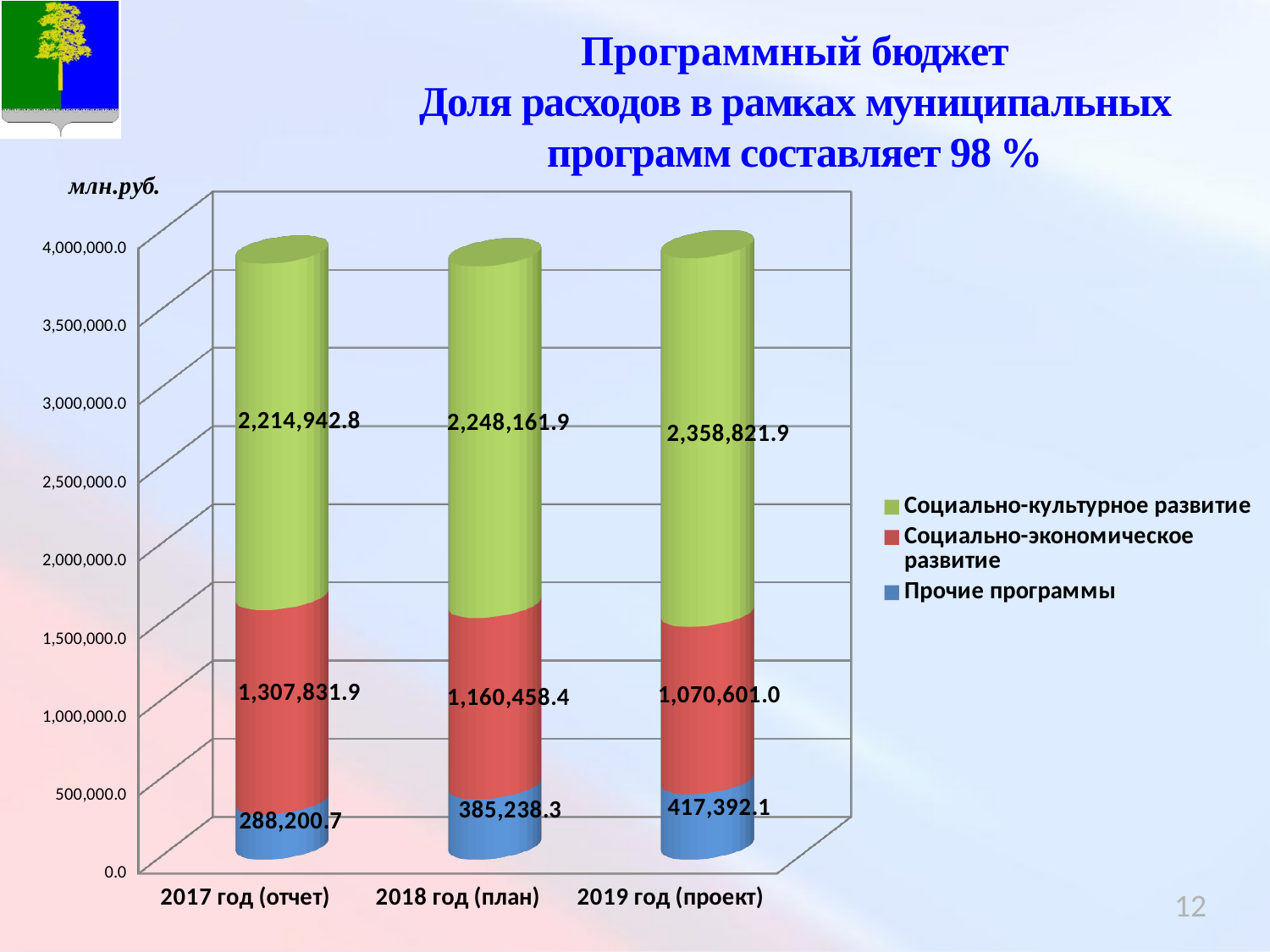
What is the difference between the Социально-экономическое развитие values for 2017 год (отчет) and 2019 год (проект)? 237,230.9 What is the total of the stacked bar for 2019 год (проект)? 3,846,815.0 Which is larger: Социально-культурное развитие in 2018 год (план) or in 2019 год (проект)? 2019 год (проект) How many series does the legend list? 3 How many years (categories) are shown on the x axis? 3 What is the value for Прочие программы in 2019 год (проект)? 417,392.1 What is the value for Социально-культурное развитие in 2017 год (отчет)? 2,214,942.8 What kind of chart is shown on the slide? Stacked bar chart In which year is the value for Социально-культурное развитие the highest? 2019 год (проект) In which year is the value for Прочие программы the lowest? 2017 год (отчет) Do the values for Социально-экономическое развитие rise or fall from 2017 to 2019? Fall What is the value for Социально-экономическое развитие in 2018 год (план)? 1,160,458.4